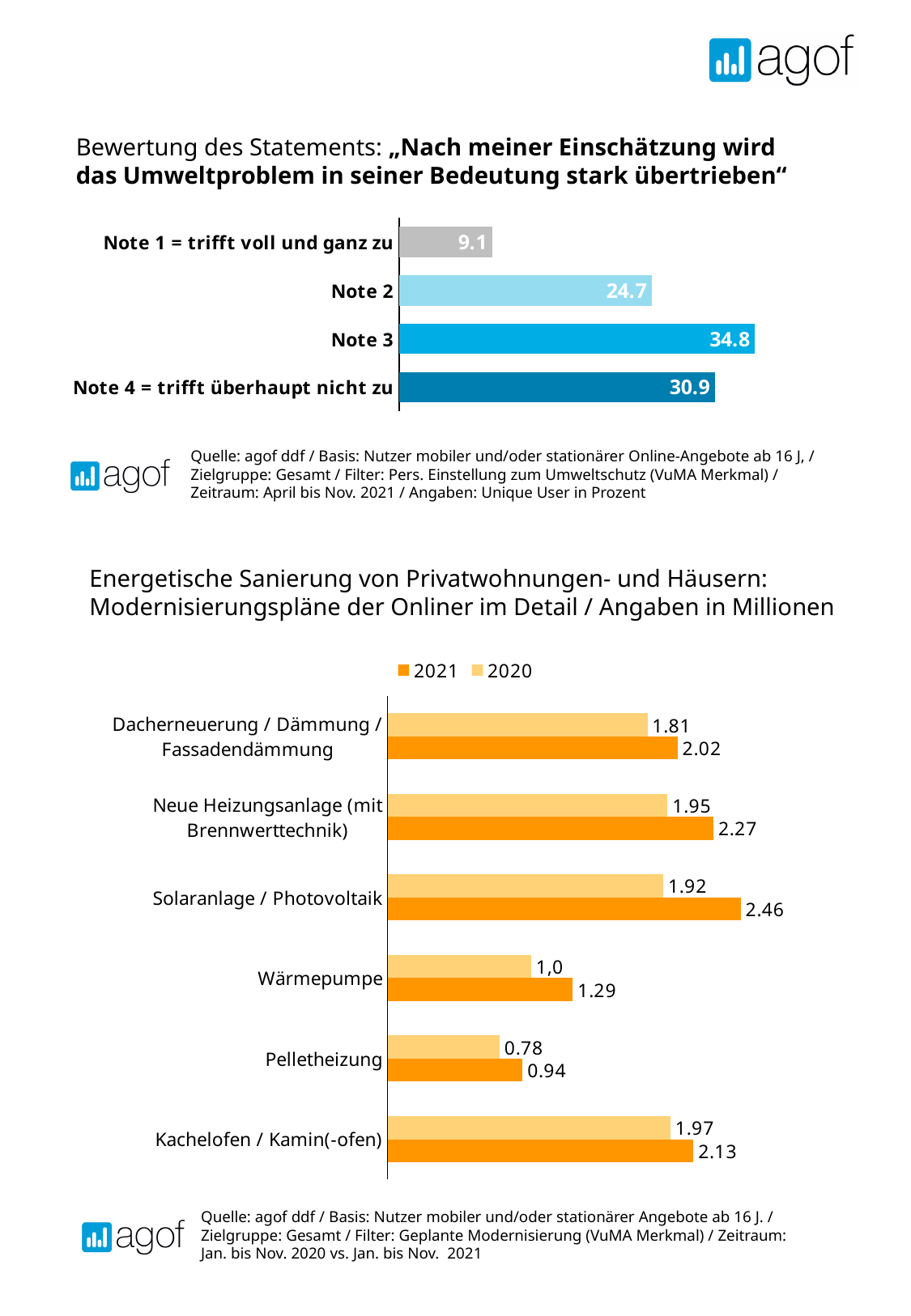
In the bottom chart (Energetische Sanierung), what is the 2021 value for Solaranlage / Photovoltaik? 2.46 In the bottom chart (Energetische Sanierung), what is the difference between the 2021 and 2020 values for Wärmepumpe? 0.29 In the top chart (Bewertung des Statements), which category has the lowest value? Note 1 = trifft voll und ganz zu In the top chart (Bewertung des Statements), how many categories are shown? 4 In the top chart (Bewertung des Statements), what is the value for Note 1 = trifft voll und ganz zu? 9.1 In the bottom chart (Energetische Sanierung), how many series does the legend list? 2 What kind of chart is the bottom chart (Energetische Sanierung)? Bar chart In the top chart (Bewertung des Statements), which category has the highest value? Note 3 In the bottom chart (Energetische Sanierung), which category has the highest 2021 value? Solaranlage / Photovoltaik In the top chart (Bewertung des Statements), what is the value for Note 3? 34.8 In the top chart (Bewertung des Statements), what is the difference between Note 3 and Note 4 = trifft überhaupt nicht zu? 3.9 In the bottom chart (Energetische Sanierung), what is the 2020 value for Pelletheizung? 0.78